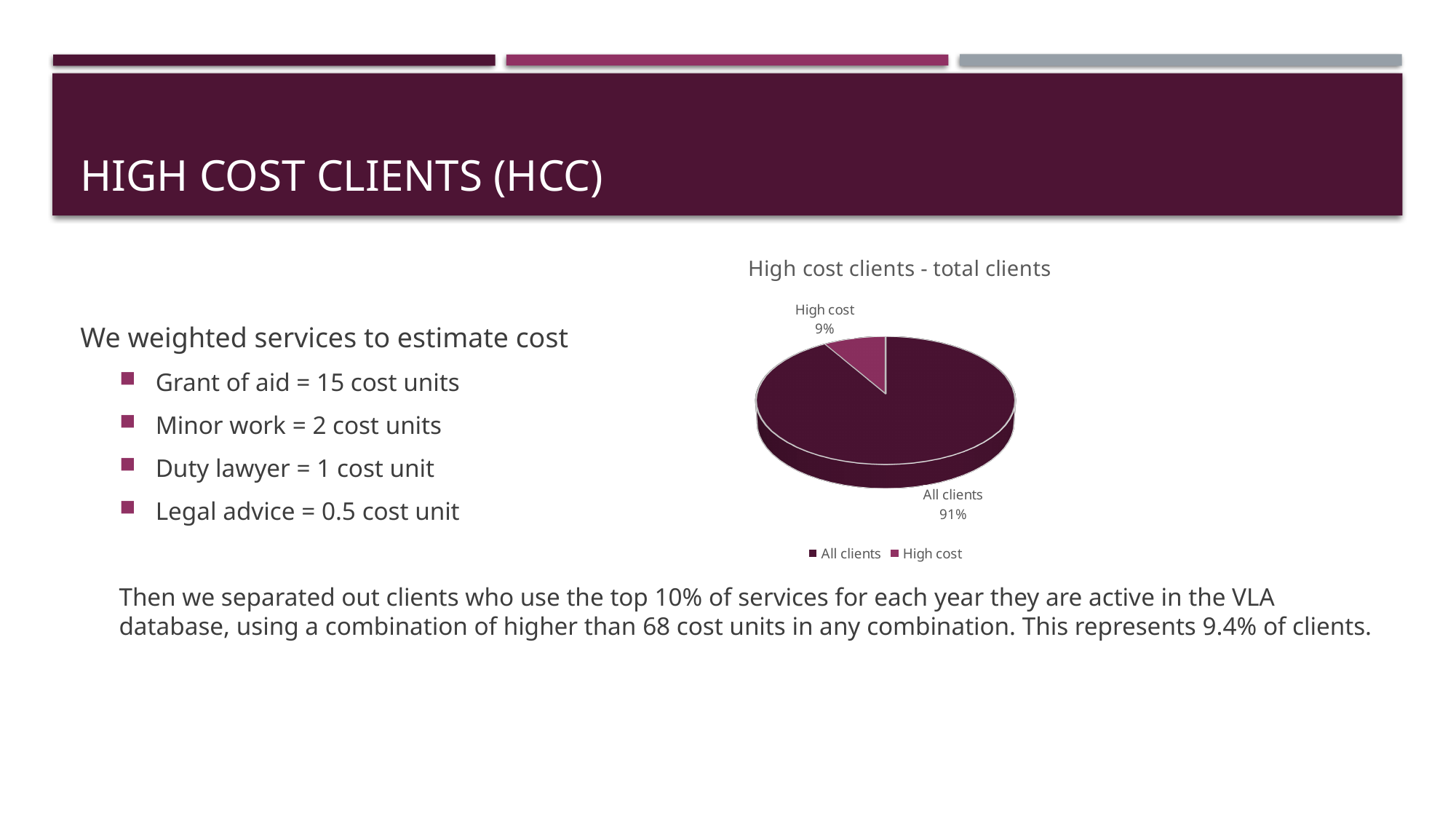
What is the difference in percentage points between the All clients slice and the High cost slice? 82 What share of the pie is labelled All clients? 91% How many slices does the pie chart have? 2 Which slice of the pie is the largest? All clients What is the title of the chart? High cost clients - total clients How many entries does the chart legend list? 2 Which slice is larger, All clients or High cost? All clients What kind of chart is shown on the slide? Pie chart What share of the pie is labelled High cost? 9% Which slice of the pie is the smallest? High cost Which legend entry is shown in the lighter magenta colour? High cost